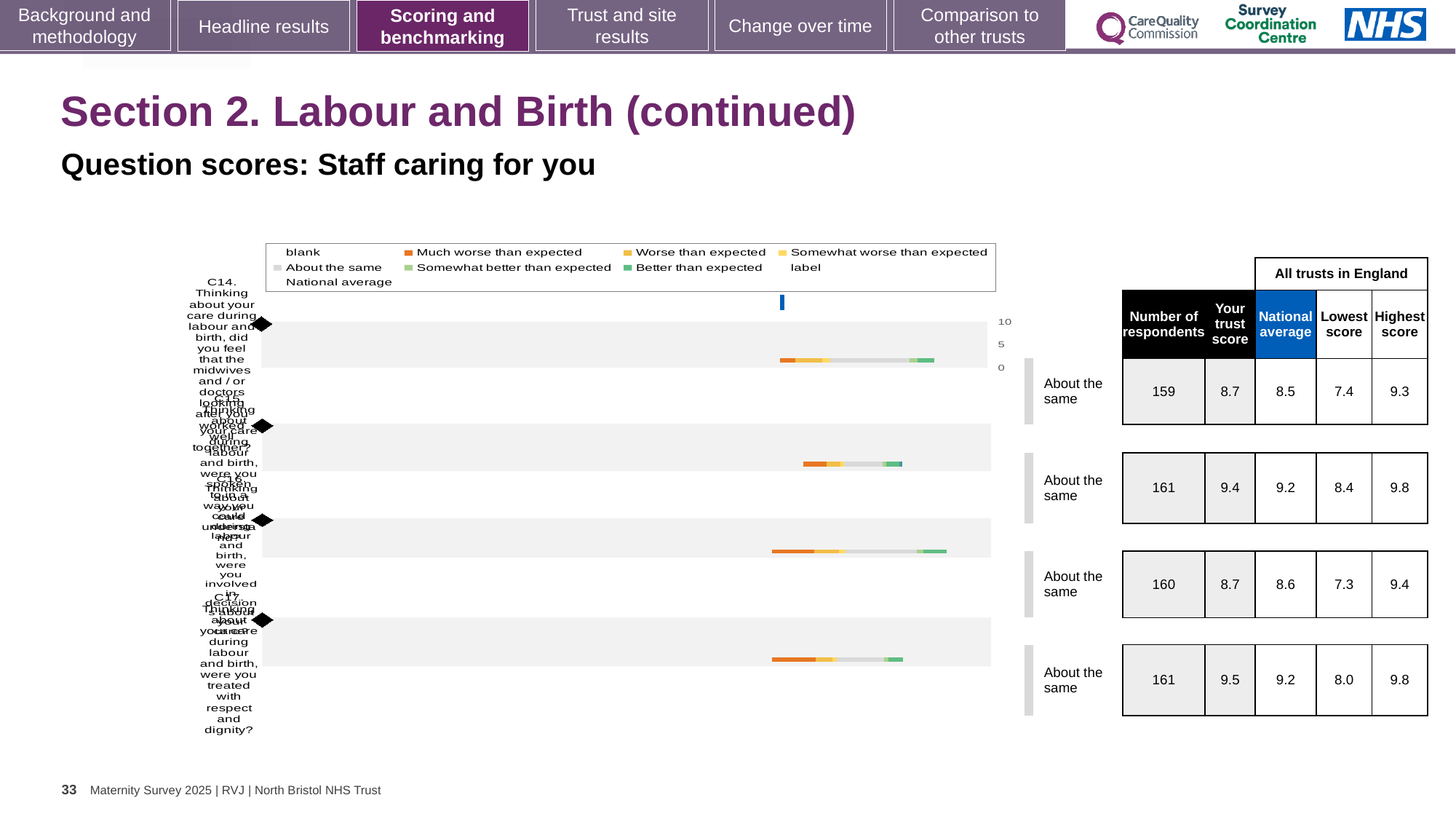
In the table beside the chart, what is the number of respondents for the third row (C16)? 160 Which row in the table beside the chart has the highest trust score? the fourth row (C17) What kind of chart is shown on the slide? bar chart In the table beside the chart, what is the trust score for the first row (C14)? 8.7 In the chart legend, which colour represents 'Better than expected'? green In the table beside the chart, what is the lowest score for the first row (C14)? 7.4 In the table beside the chart, what is the highest score for the fourth row (C17)? 9.8 Which row in the table beside the chart has the lowest 'Lowest score' value? the third row (C16) How many question rows (bars) does the chart show? 4 In the chart legend, which colour represents 'Much worse than expected'? orange What is the difference between the trust score and the national average for the fourth row (C17) in the table beside the chart? 0.3 In the table beside the chart, what is the national average for the second row (C15)? 9.2